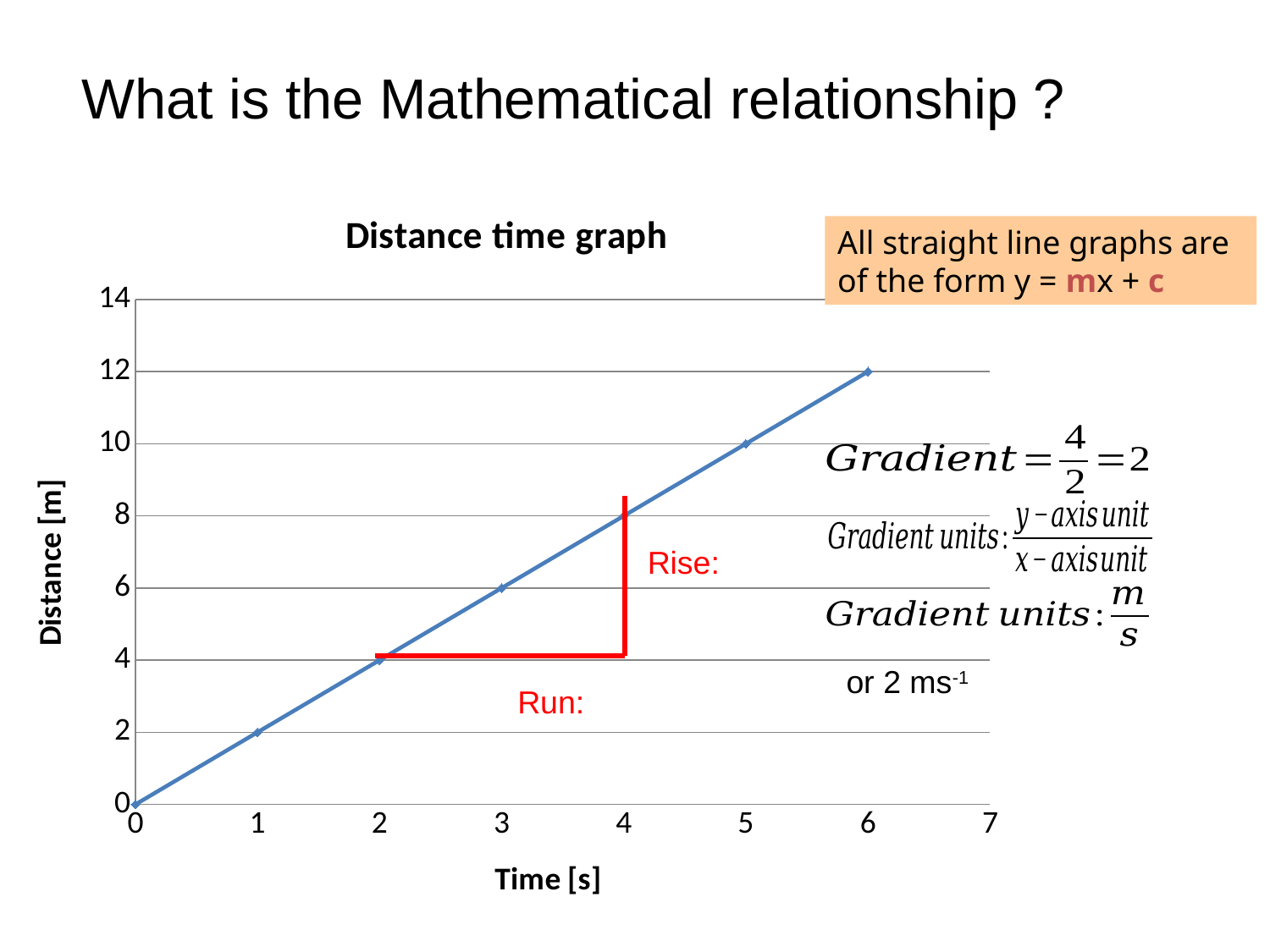
At which time is the distance highest? 6 What is the distance at time 6 s? 12 What is the distance at time 3 s? 6 What is the difference in distance between time 4 s and time 2 s? 4 Which is larger, the distance at time 5 s or at time 2 s? time 5 s At which time is the distance lowest? 0 Does the distance rise or fall as time increases? rise What is the label of the y axis? Distance [m] What is the title of the chart? Distance time graph What is the distance at time 1 s? 2 How many data points are plotted on the line? 7 What type of chart is shown on the slide? line chart